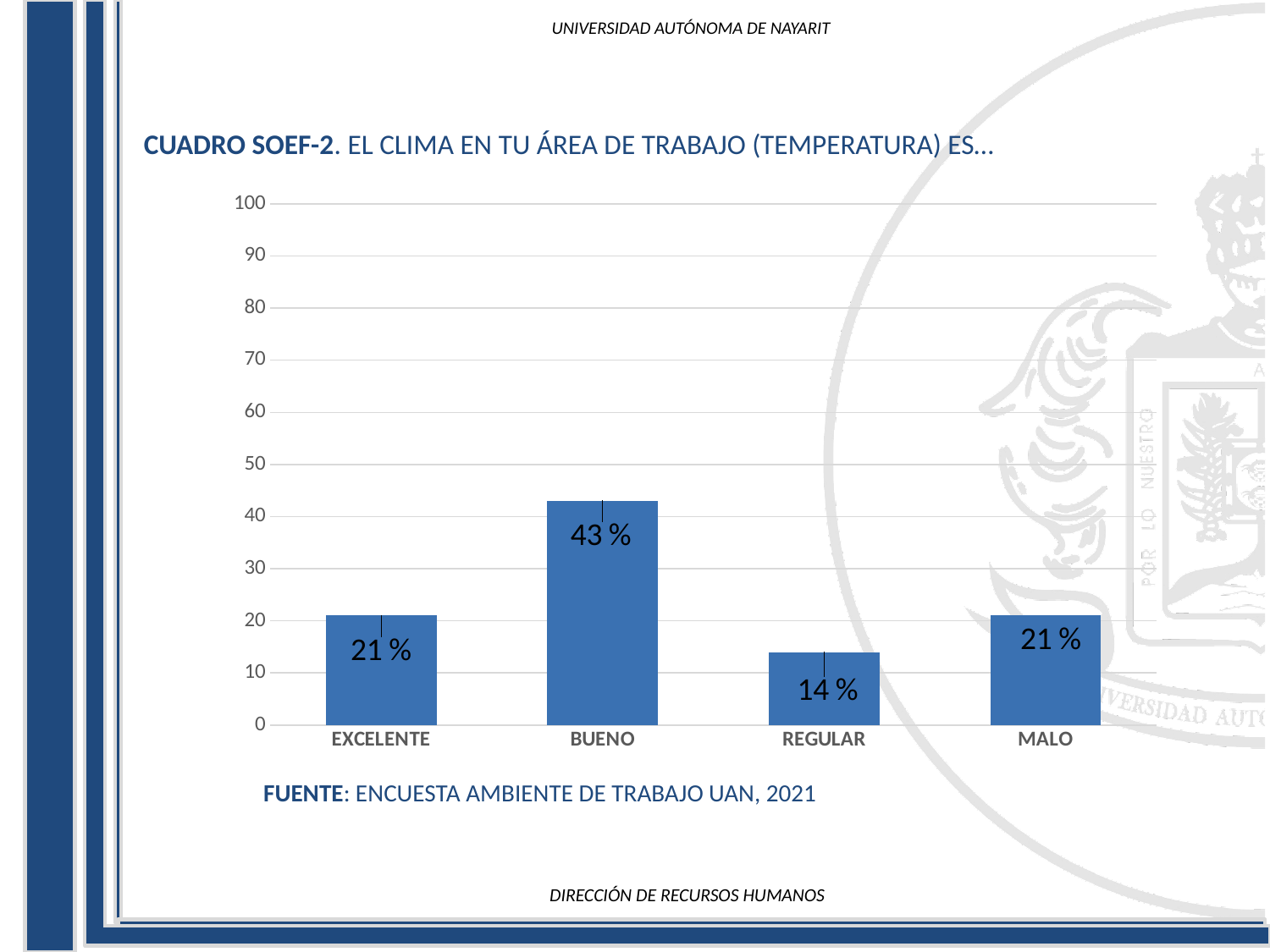
Which category has the lowest value? REGULAR What is the title of the chart? CUADRO SOEF-2. EL CLIMA EN TU ÁREA DE TRABAJO (TEMPERATURA) ES… Which category has the highest value? BUENO How many categories are shown on the x axis? 4 What is the value for BUENO? 43 % What kind of chart is shown on the slide? bar chart What is the difference between the values for MALO and REGULAR? 7 % What is the value for EXCELENTE? 21 % What is the difference between the values for BUENO and REGULAR? 29 % Is the value for BUENO greater or less than 40? greater Which is larger, the value for BUENO or the value for MALO? BUENO What is the value for REGULAR? 14 %